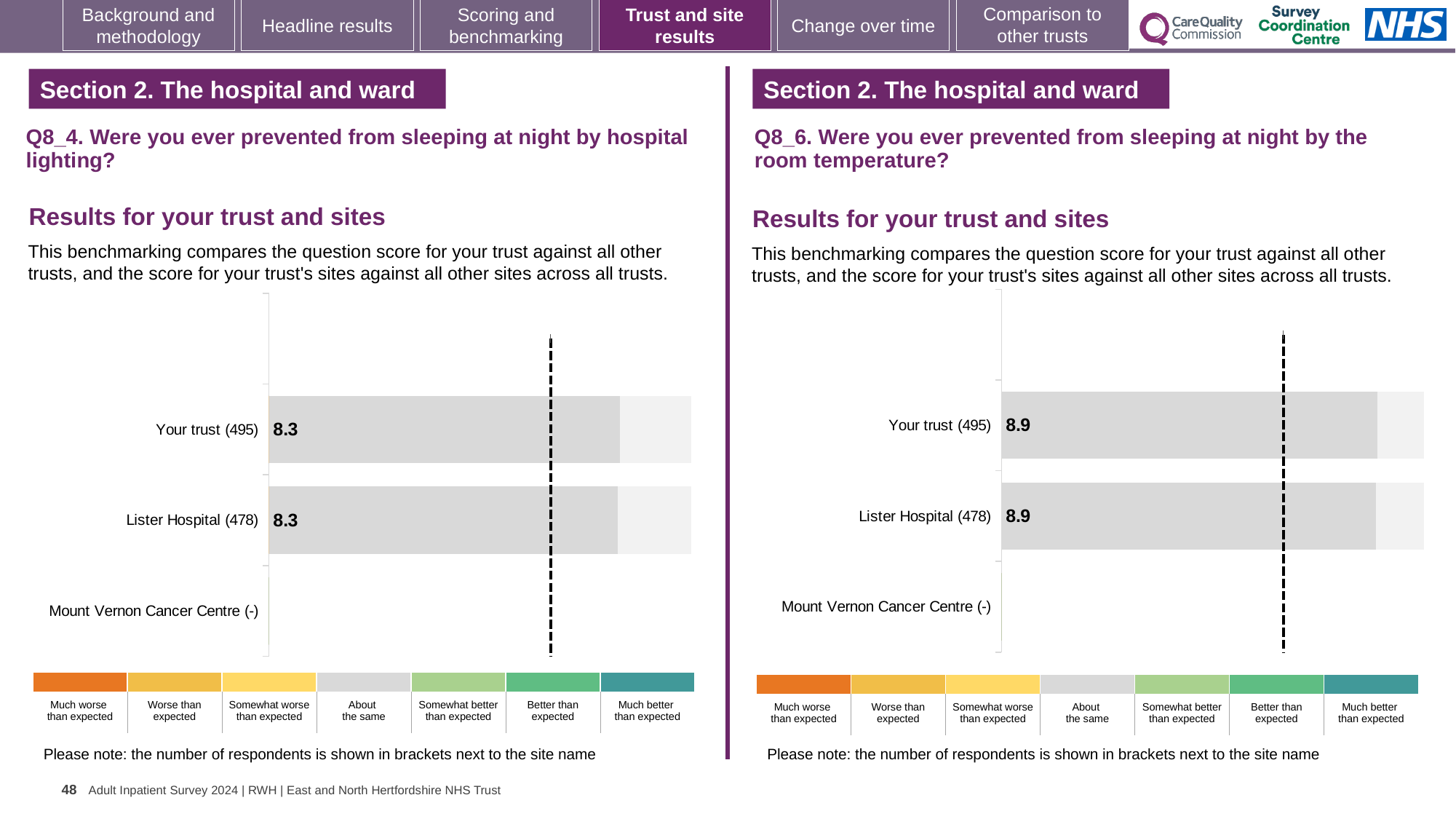
In the Q8_4 chart (hospital lighting), what is the score for Your trust? 8.3 How many sites or categories are listed on the y axis of the Q8_6 chart (room temperature)? 3 In the Q8_6 chart (room temperature), what is the score for Lister Hospital? 8.9 In the Q8_6 chart (room temperature), what is the difference between the scores for Your trust and Lister Hospital? 0 In the Q8_4 chart (hospital lighting), how many respondents are shown in brackets for Lister Hospital? 478 In the Q8_6 chart (room temperature), which site has no score bar shown? Mount Vernon Cancer Centre In the Q8_4 chart (hospital lighting), what is the score for Lister Hospital? 8.3 In the Q8_6 chart (room temperature), what is the score for Your trust? 8.9 How many sites or categories are listed on the y axis of the Q8_4 chart (hospital lighting)? 3 In the Q8_6 chart (room temperature), how many respondents are shown in brackets for Your trust? 495 What kind of chart is used for the Q8_4 results (hospital lighting)? Bar chart In the Q8_4 chart (hospital lighting), what is the difference between the scores for Your trust and Lister Hospital? 0